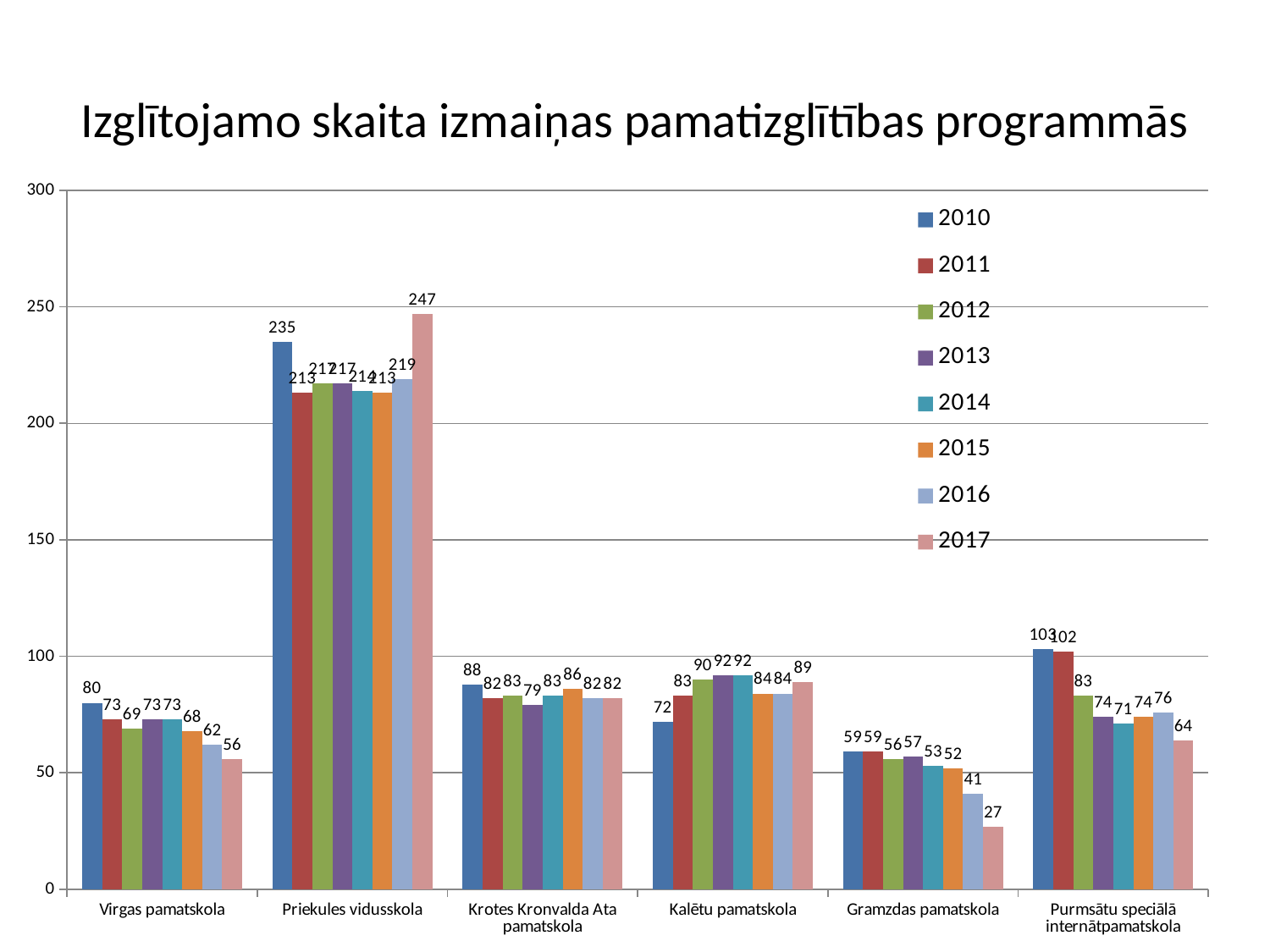
What is the value for Priekules vidusskola in 2017? 247 Which school has the highest value in 2017? Priekules vidusskola How many series does the legend list? 8 What is the difference between the 2017 and 2010 values for Priekules vidusskola? 12 What kind of chart is shown on the slide? bar chart How many schools are shown on the x axis? 6 Which is larger in 2013: the value for Kalētu pamatskola or for Krotes Kronvalda Ata pamatskola? Kalētu pamatskola Which school has the lowest value in 2017? Gramzdas pamatskola What is the value for Virgas pamatskola in 2010? 80 What is the value for Gramzdas pamatskola in 2017? 27 Is the value for Purmsātu speciālā internātpamatskola in 2010 greater or less than 100? greater Do the values for Gramzdas pamatskola rise or fall from 2010 to 2017? fall